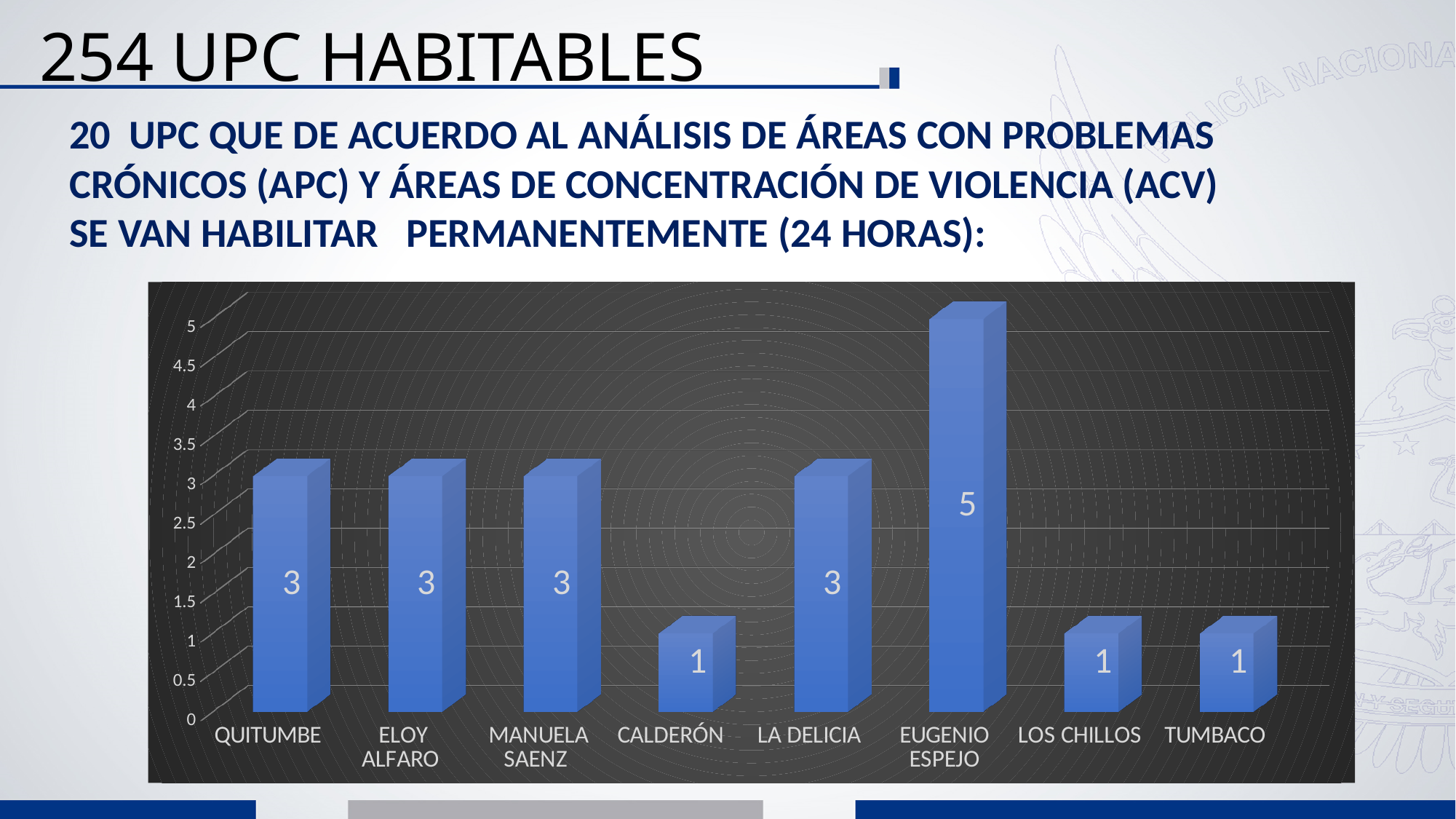
What is the difference between the values for EUGENIO ESPEJO and QUITUMBE? 2 What is the difference between the values for LA DELICIA and LOS CHILLOS? 2 Which category has the highest value? EUGENIO ESPEJO What kind of chart is shown on the slide? bar chart How many categories are shown on the x axis? 8 What is the value for ELOY ALFARO? 3 How many categories have a value of 3? 4 What is the value for LA DELICIA? 3 What is the value for EUGENIO ESPEJO? 5 What is the highest tick value shown on the vertical axis? 5 What is the value for CALDERÓN? 1 Which is larger, the value for MANUELA SAENZ or the value for TUMBACO? MANUELA SAENZ